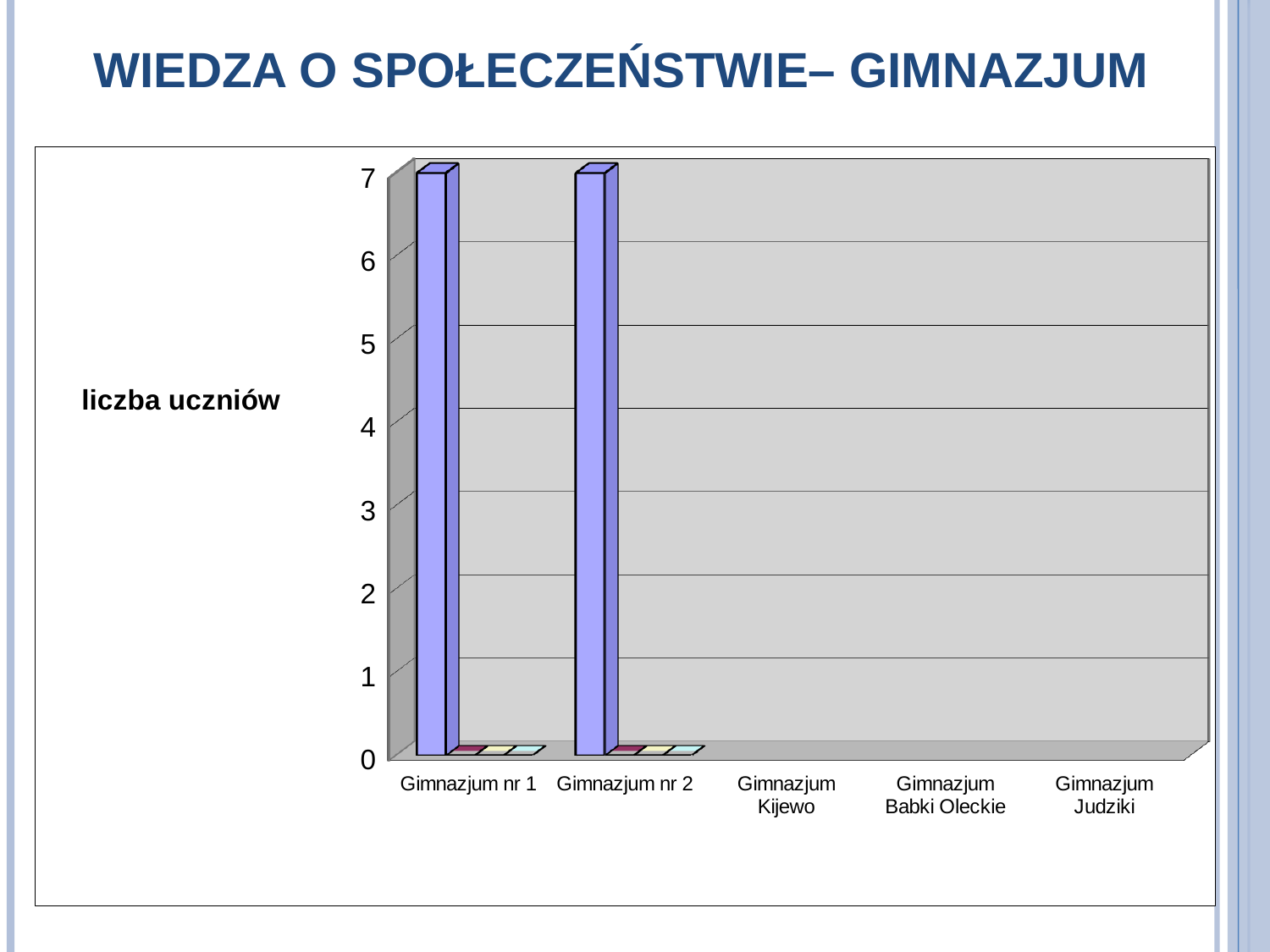
What kind of chart is shown on the slide? bar chart What is the value for Gimnazjum nr 2? 7 How many categories are shown on the x axis of the chart? 5 What is the label of the vertical axis of the chart? liczba uczniów What is the title of the slide containing the chart? WIEDZA O SPOŁECZEŃSTWIE– GIMNAZJUM What is the difference between the values for Gimnazjum nr 1 and Gimnazjum nr 2? 0 What is the highest value shown on the vertical axis of the chart? 7 Is the value for Gimnazjum nr 1 greater or less than 5? greater What is the value for Gimnazjum nr 1? 7